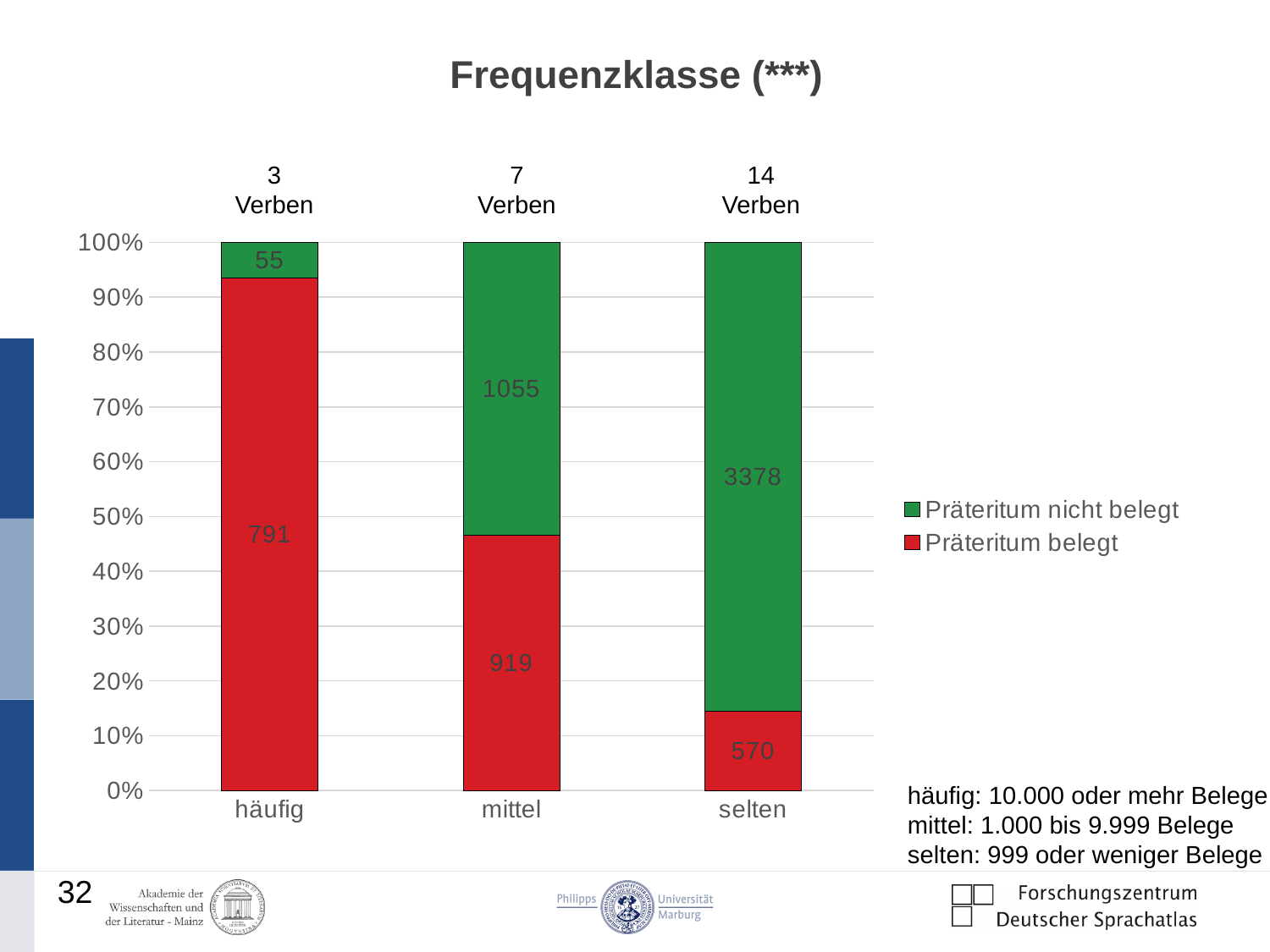
How many series does the legend list? 2 What is the total of the stacked bar for the 'selten' category? 3948 What is the value of 'Präteritum nicht belegt' for the 'selten' category? 3378 What is the title of the chart? Frequenzklasse (***) What is the value of 'Präteritum belegt' for the 'selten' category? 570 Which category has the highest value for 'Präteritum nicht belegt'? selten Which category has the lowest value for 'Präteritum belegt'? selten How many categories are shown on the x axis? 3 What is the value of 'Präteritum belegt' for the 'häufig' category? 791 What is the value of 'Präteritum nicht belegt' for the 'mittel' category? 1055 What is the difference between 'Präteritum nicht belegt' and 'Präteritum belegt' in the 'mittel' category? 136 In the 'häufig' category, which is larger: 'Präteritum belegt' or 'Präteritum nicht belegt'? Präteritum belegt